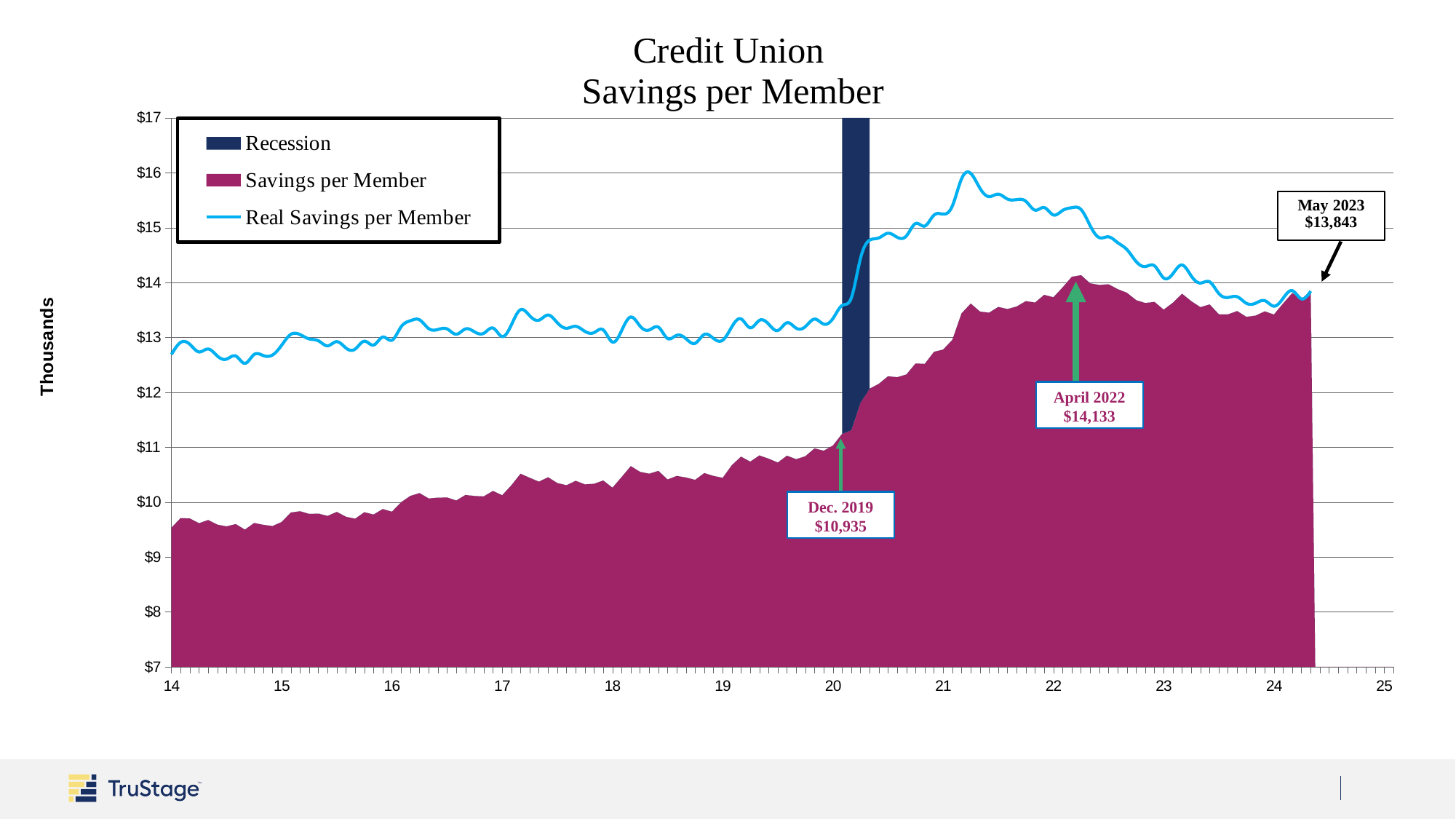
What is the Savings per Member value labelled for April 2022? $14,133 Is the Savings per Member value at the start of 2014 greater or less than $10? less What is the title of the chart? Credit Union Savings per Member What value is labelled for May 2023? $13,843 What is the Savings per Member value labelled for Dec. 2019? $10,935 What is the difference between the April 2022 value ($14,133) and the Dec. 2019 value ($10,935)? $3,198 Is the peak of the Real Savings per Member line in 2021 greater or less than $15? greater Does Savings per Member generally rise or fall from 2014 to 2022? rise What unit label is shown on the vertical axis? Thousands How many entries does the chart legend list? 3 Which of the labelled points is higher, Dec. 2019 or April 2022? April 2022 What is the difference between the April 2022 value ($14,133) and the May 2023 value ($13,843)? $290